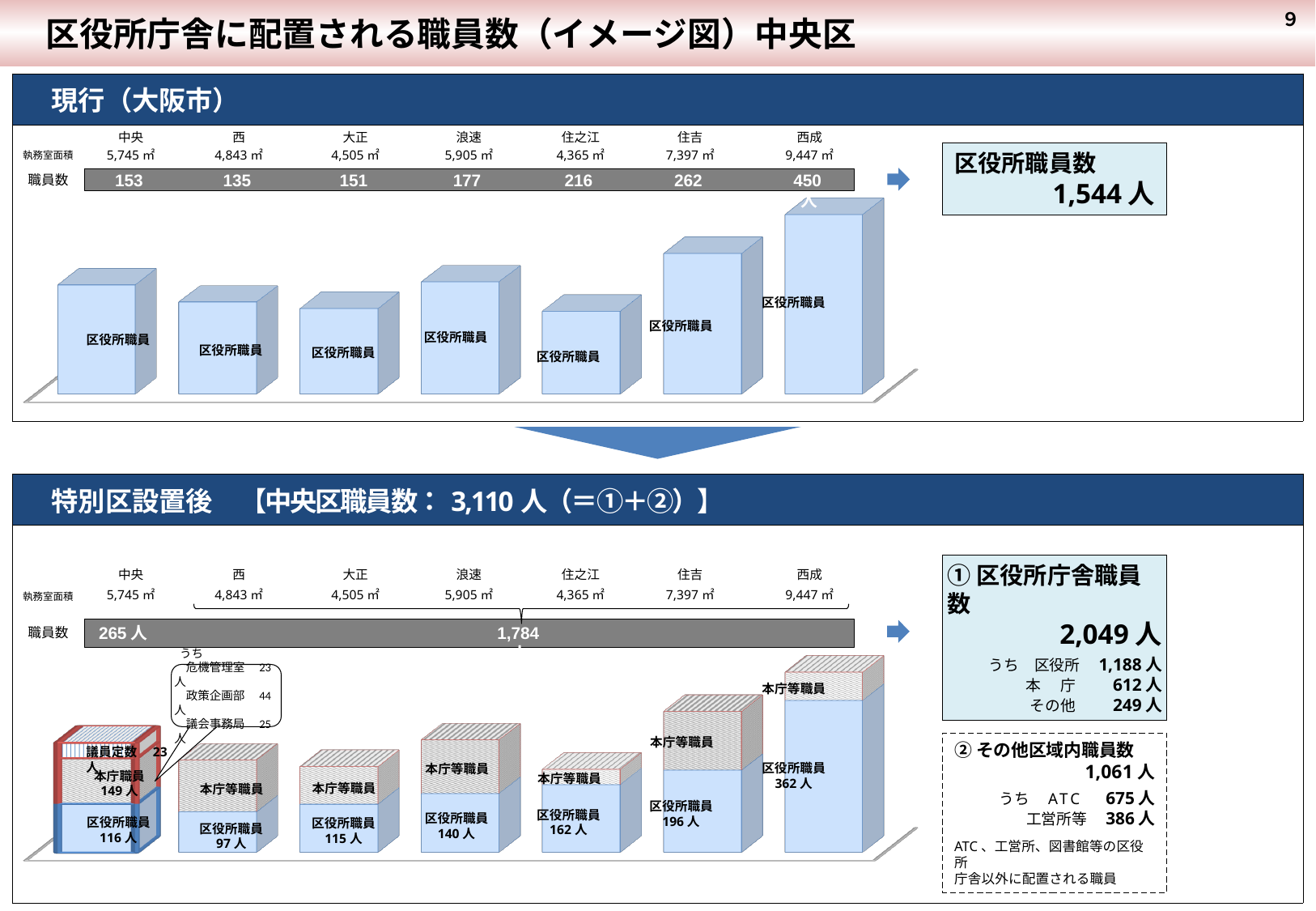
In the bottom chart (特別区設置後), what is the 区役所職員 value for 西成? 362 人 In the bottom chart (特別区設置後), which is larger, the 区役所職員 value for 浪速 or for 住之江? 住之江 In the top chart (現行（大阪市）), which ward has the highest 職員数? 西成 In the top chart (現行（大阪市）), what is the 職員数 value for 西成? 450 In the top chart (現行（大阪市）), which ward has the lowest 職員数? 西 In the top chart (現行（大阪市）), what is the total 区役所職員数 shown in the box on the right? 1,544 人 In the bottom chart (特別区設置後), what is the difference between the 区役所職員 values for 住吉 and 西? 99 人 In the bottom chart (特別区設置後), what is the 本庁職員 value for 中央? 149 人 In the top chart (現行（大阪市）), what is the difference in 職員数 between 住吉 and 浪速? 85 In the top chart (現行（大阪市）), what is the 職員数 value for 住之江? 216 In the bottom chart (特別区設置後), what is the 職員数 value shown for 中央? 265 人 In the top chart (現行（大阪市）), how many wards are shown as bars? 7